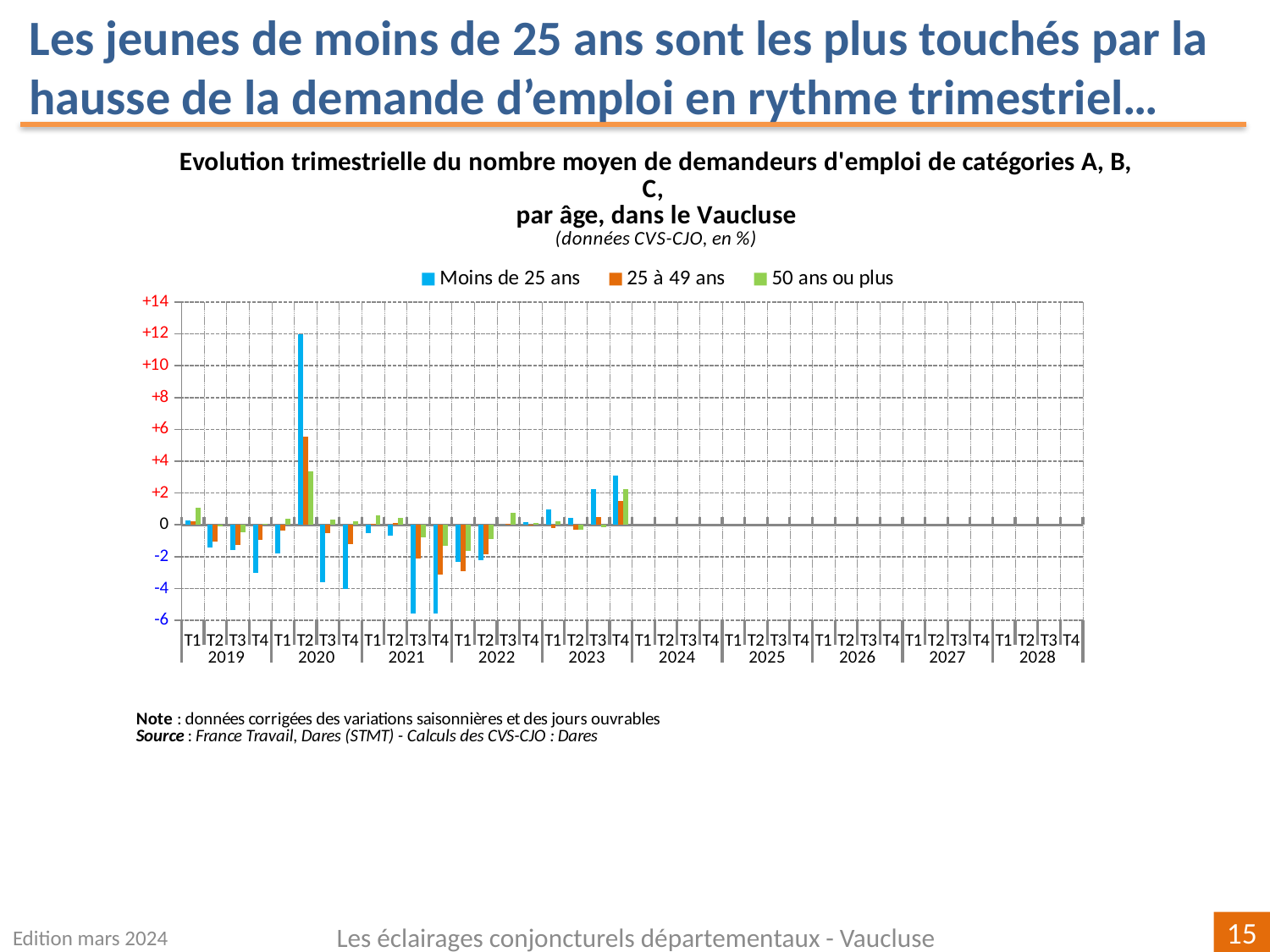
Is the value for Moins de 25 ans in T3 2021 greater or less than -4? less Which series and quarter has the highest value on the chart? Moins de 25 ans, T2 2020 How many series does the legend list? 3 Is the value for Moins de 25 ans in T4 2019 greater or less than -2? less Is the value for 50 ans ou plus in T2 2020 greater or less than +4? less In T4 2023, which is larger: Moins de 25 ans or 50 ans ou plus? Moins de 25 ans Which series has the lowest value on the chart? Moins de 25 ans In T2 2020, which is larger: Moins de 25 ans or 25 à 49 ans? Moins de 25 ans What colour represents the series Moins de 25 ans in the legend? blue What kind of chart is shown on the slide? bar chart